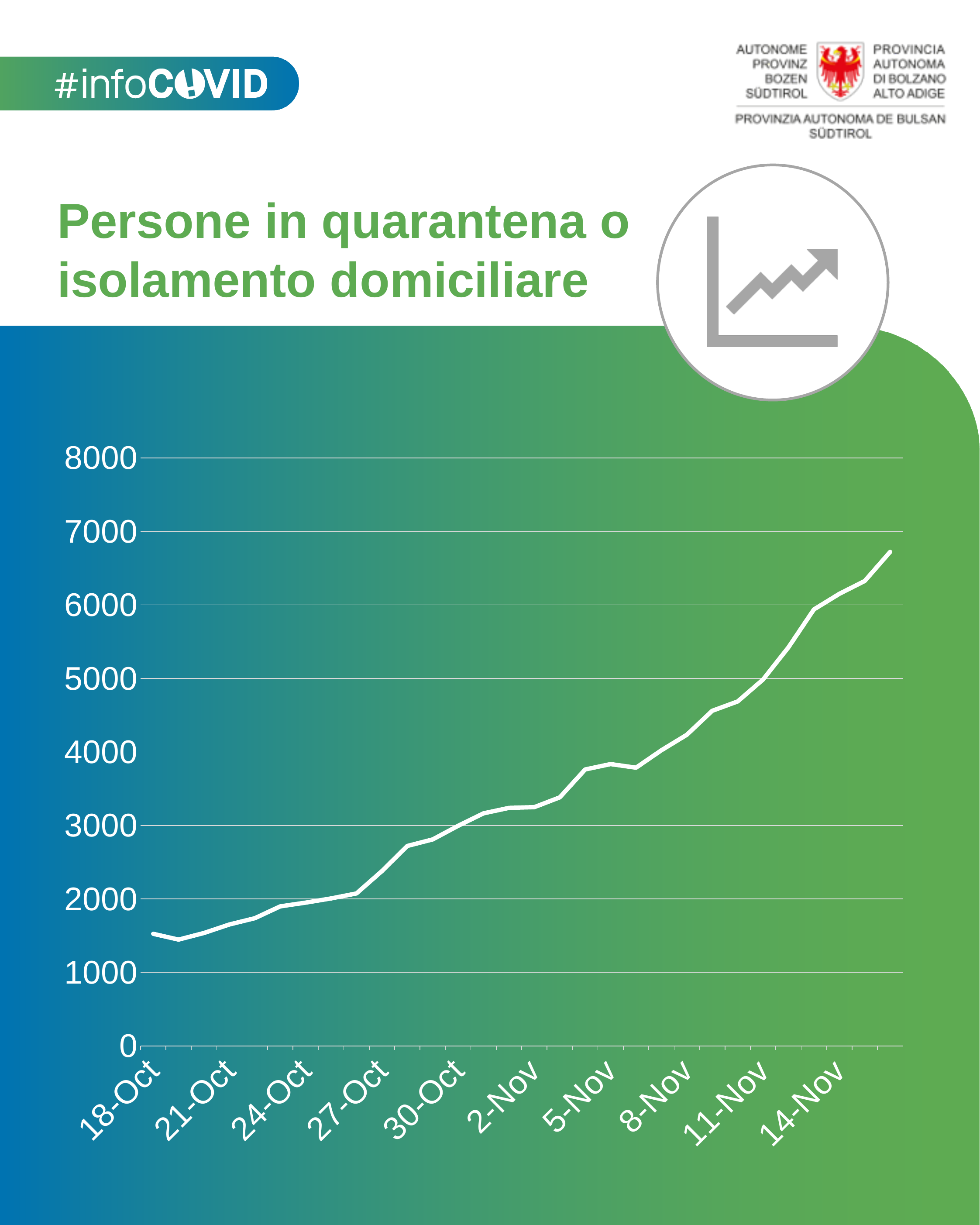
Is the value for 5-Nov greater or less than 4000? less How many date labels are shown on the x axis? 10 Do the values generally rise or fall from 18-Oct to 14-Nov? rise Which is larger, the value for 5-Nov or the value for 2-Nov? 5-Nov Is the value for 18-Oct greater or less than 2000? less Is the value for 8-Nov greater or less than 4000? greater What is the title of the chart on the slide? Persone in quarantena o isolamento domiciliare What is the highest value shown on the y axis? 8000 What kind of chart is shown on the slide? line chart